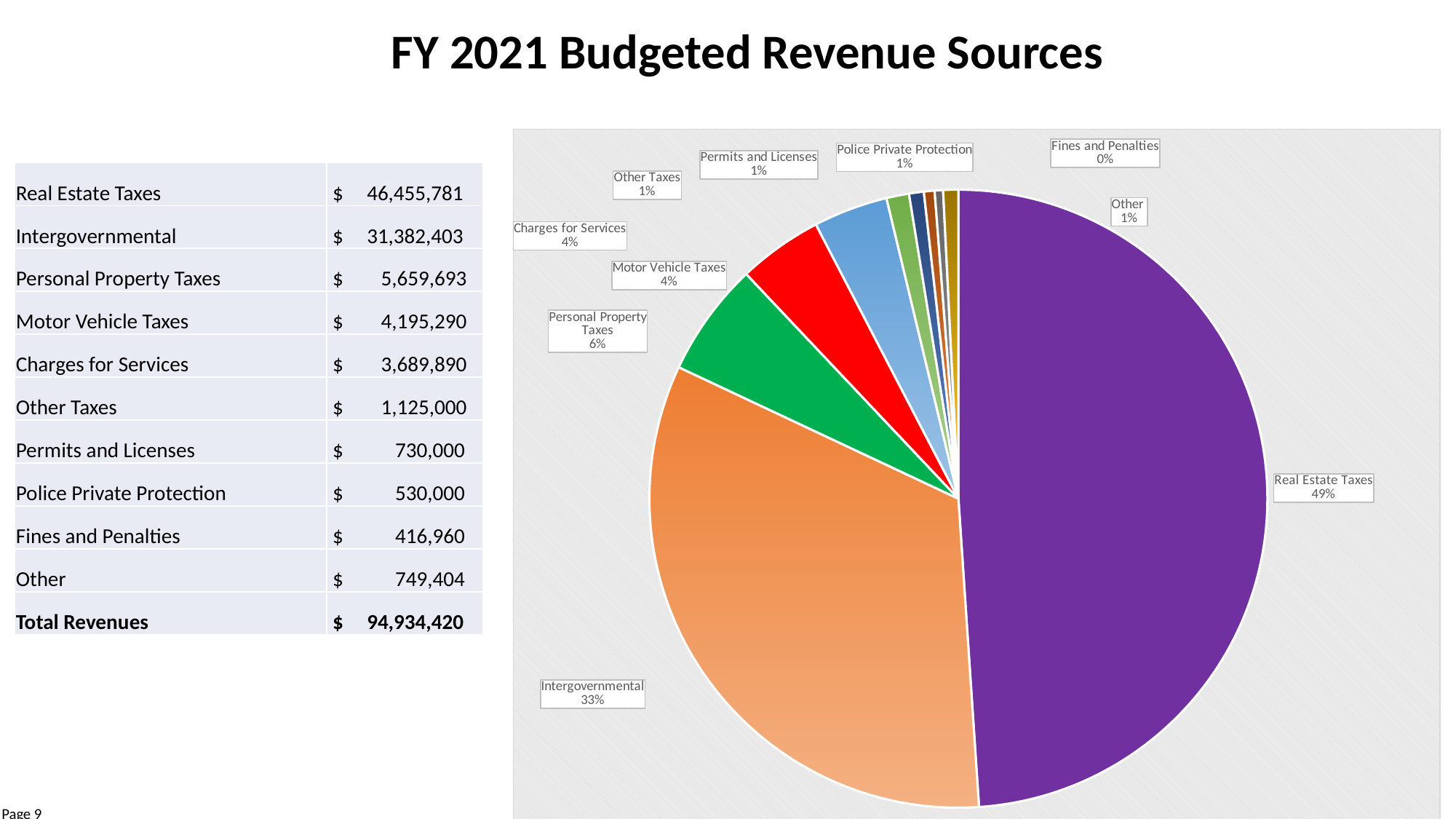
What share of the pie does Motor Vehicle Taxes represent? 4% Which slice of the pie is the largest? Real Estate Taxes What share of the pie does Real Estate Taxes represent? 49% Which slice of the pie is the smallest? Fines and Penalties What share of the pie does Intergovernmental represent? 33% What is the difference in percentage points between the Real Estate Taxes slice and the Intergovernmental slice? 16 Which slice is larger, Intergovernmental or Personal Property Taxes? Intergovernmental How many slices does the pie chart have? 10 What is the title of the slide containing the pie chart? FY 2021 Budgeted Revenue Sources What kind of chart is shown on the slide? pie chart